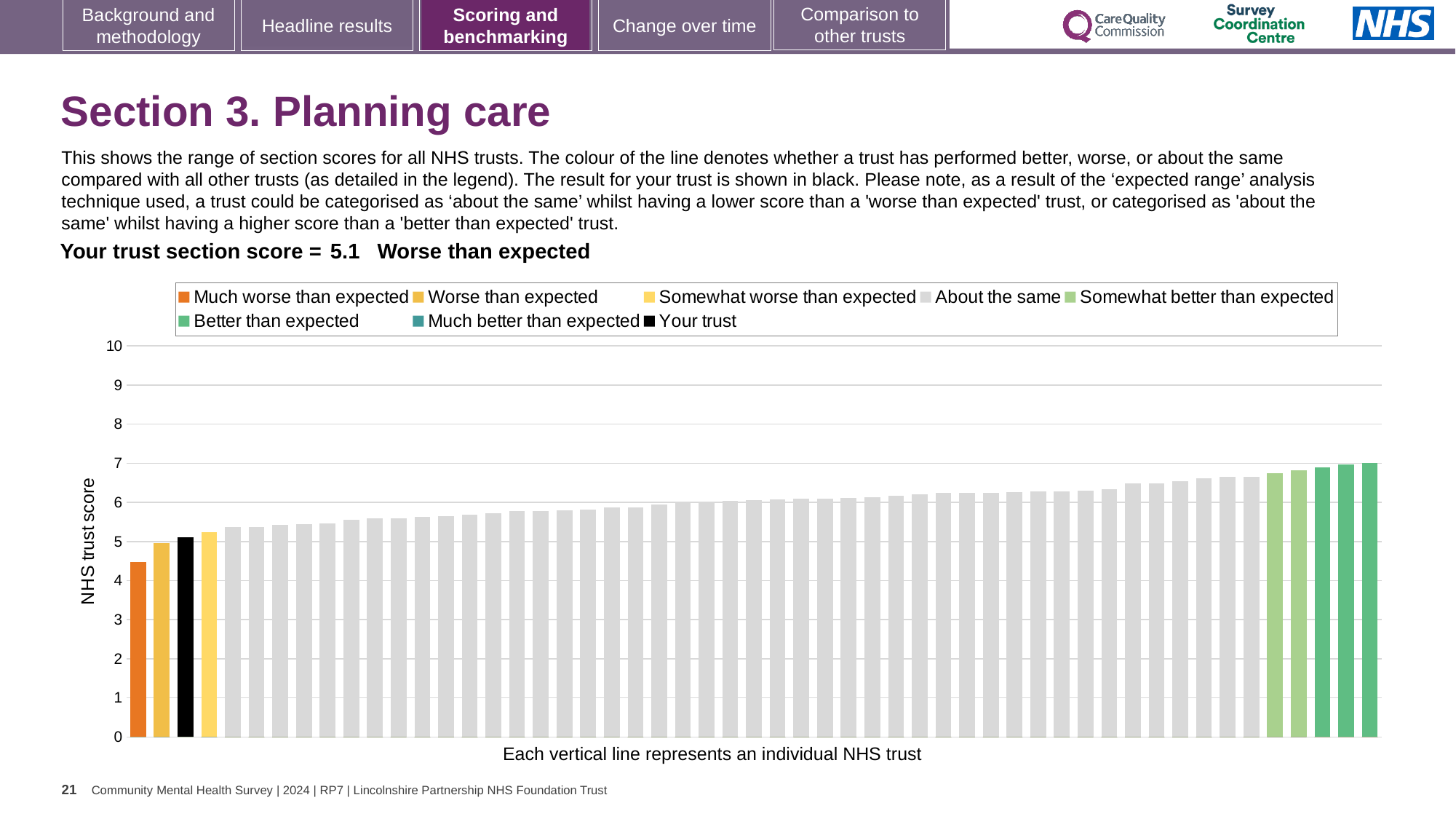
How many entries does the chart legend list? 8 How many bars are coloured as 'Better than expected' (dark green)? 3 Is the value of the leftmost (orange) bar greater or less than 5? less Is the value for your trust (the black bar) greater or less than 6? less Do the bar values rise or fall from left to right along the x axis? rise Is the leftmost orange bar higher or lower than the black bar for your trust? lower How many bars are coloured as 'Much worse than expected' (orange)? 1 What kind of chart is shown on the slide? bar chart Is the value of the tallest bar on the chart greater or less than 6? greater What is the label on the vertical axis of the chart? NHS trust score What is the section score for your trust shown on the slide? 5.1 Which performance category is your trust placed in for Section 3. Planning care? Worse than expected